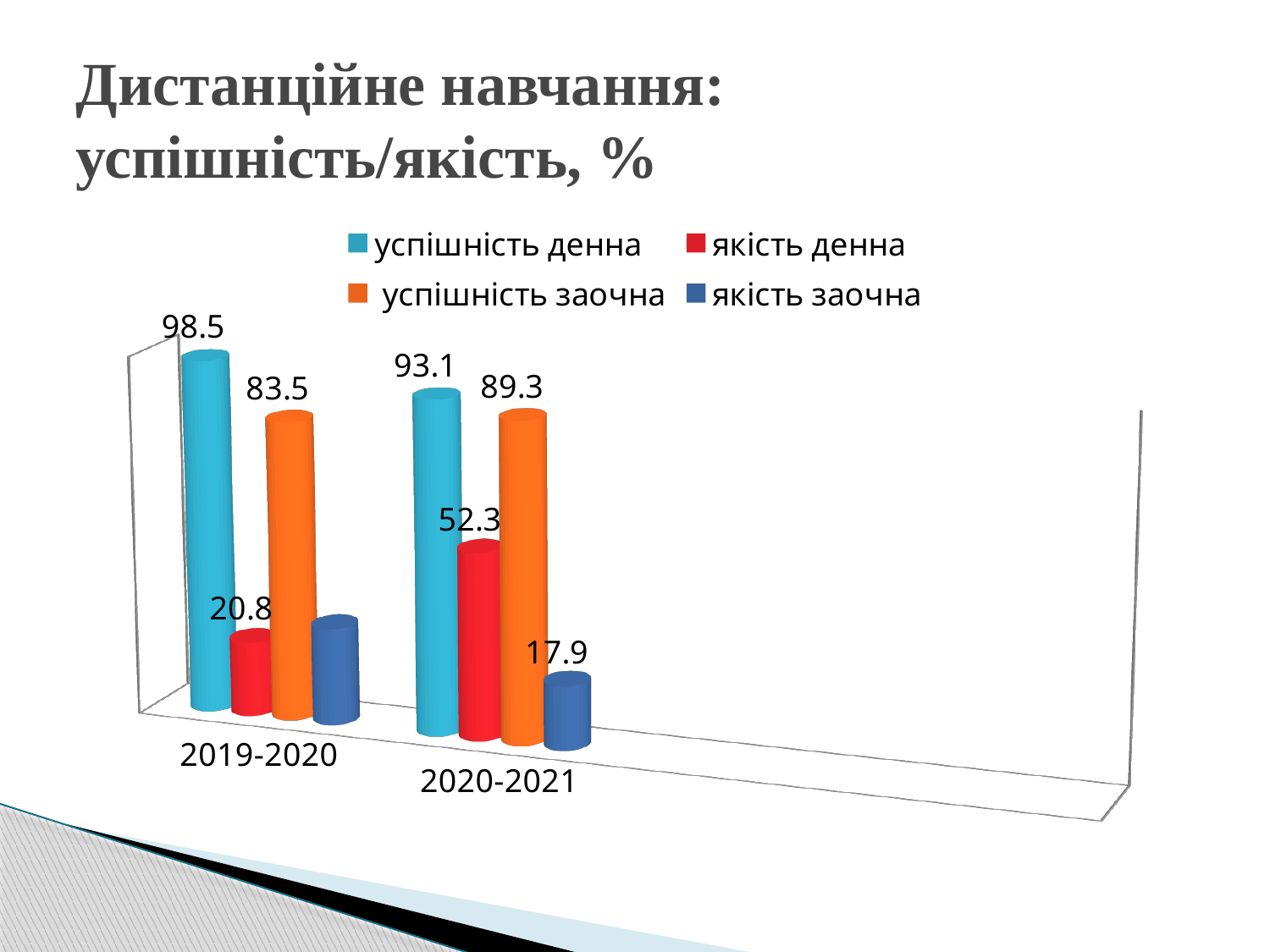
What is the value of якість заочна for 2020-2021? 17.9 What is the difference between якість денна in 2020-2021 and in 2019-2020? 31.5 How many academic years are shown on the x axis? 2 What is the value of успішність заочна for 2019-2020? 83.5 What kind of chart is shown on the slide? bar chart By how much did успішність денна decrease from 2019-2020 to 2020-2021? 5.4 How many series does the legend list? 4 Which series has the highest value for 2019-2020? успішність денна Which year has the larger value for успішність заочна, 2019-2020 or 2020-2021? 2020-2021 Which series has the lowest value for 2020-2021? якість заочна What is the value of якість денна for 2020-2021? 52.3 What is the value of успішність денна for 2019-2020? 98.5